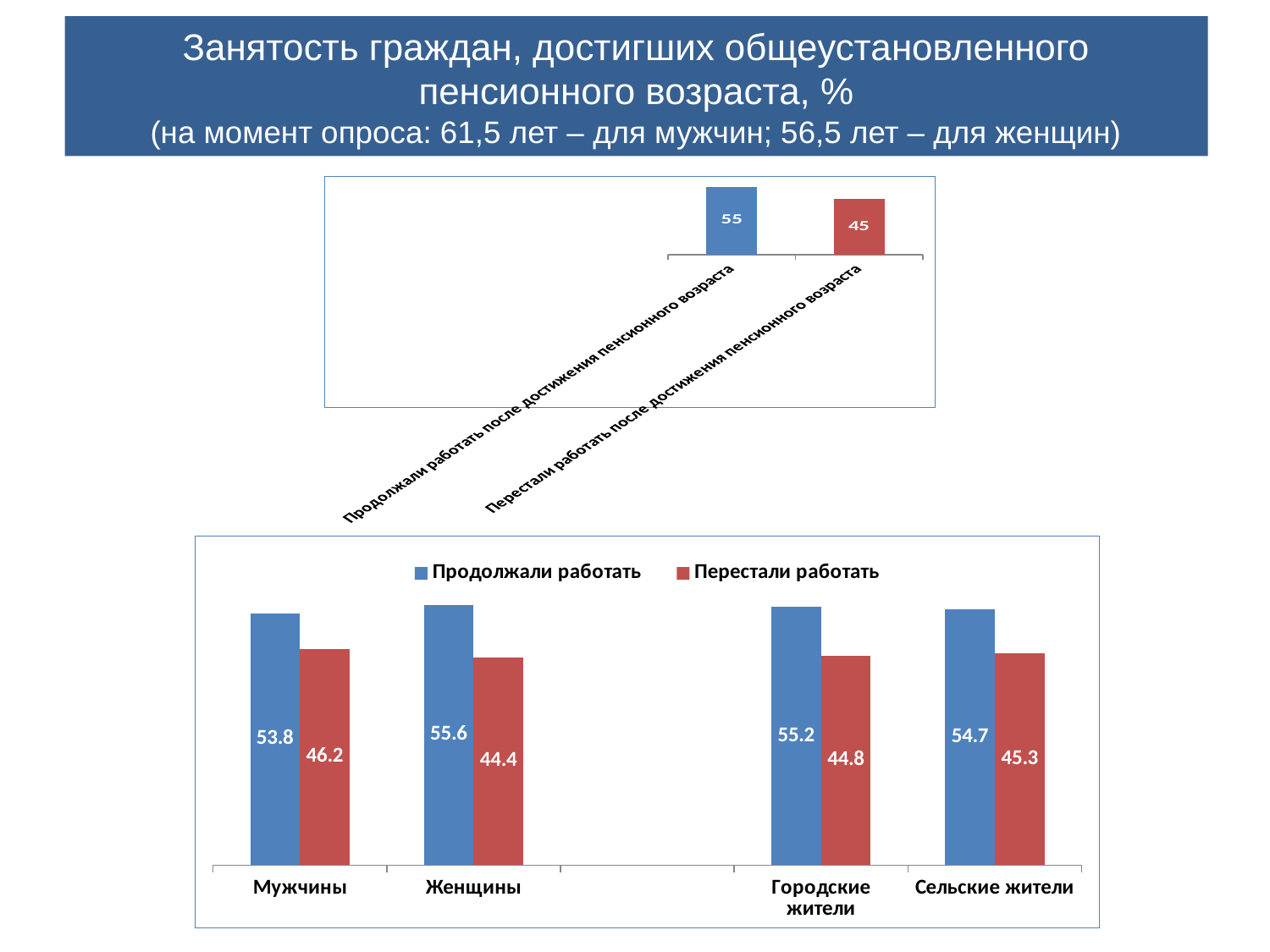
In the top chart, what is the difference between the two bars? 10 In the top chart, how many bars are plotted? 2 In the bottom chart, what is the value of "Перестали работать" for Мужчины? 46.2 In the top chart, what is the value for "Перестали работать после достижения пенсионного возраста"? 45 In the bottom chart, what is the difference between "Продолжали работать" and "Перестали работать" for Городские жители? 10.4 In the bottom chart, what is the value of "Перестали работать" for Сельские жители? 45.3 In the bottom chart, what is the value of "Продолжали работать" for Женщины? 55.6 In the bottom chart, how many series does the legend list? 2 In the bottom chart, which category has the lowest value for "Перестали работать"? Женщины What kind of chart is the bottom chart? Bar chart In the top chart, what is the value for "Продолжали работать после достижения пенсионного возраста"? 55 In the bottom chart, which category has the highest value for "Продолжали работать"? Женщины